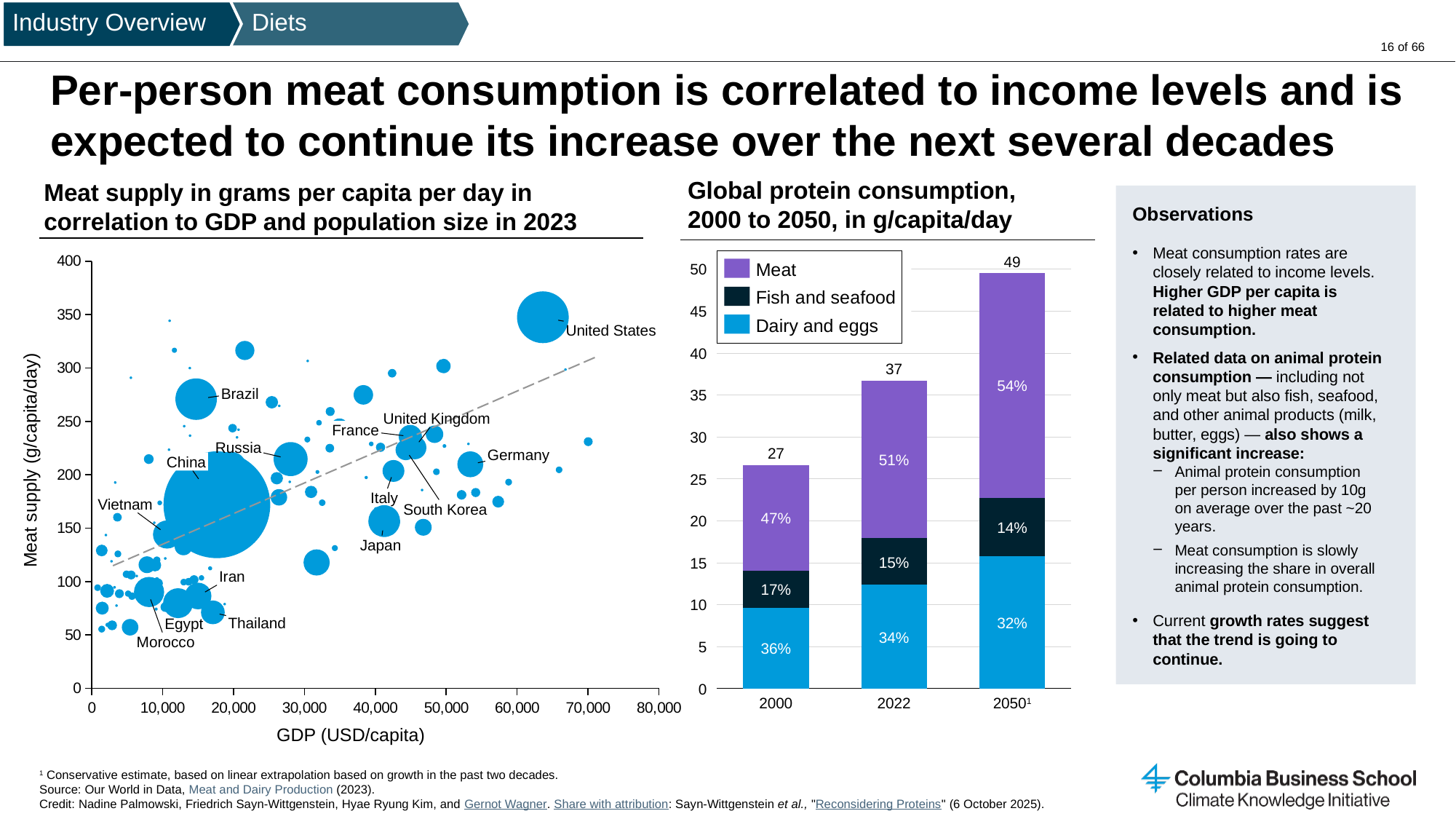
In the chart titled 'Global protein consumption, 2000 to 2050, in g/capita/day', what kind of chart is it? stacked bar chart In the chart titled 'Global protein consumption, 2000 to 2050, in g/capita/day', which year has the highest total? 2050 In the chart titled 'Meat supply in grams per capita per day in correlation to GDP and population size in 2023', is the meat supply value for the United States greater or less than 300? greater In the chart titled 'Global protein consumption, 2000 to 2050, in g/capita/day', what share of the 2050 bar is Meat? 54% In the chart titled 'Meat supply in grams per capita per day in correlation to GDP and population size in 2023', which labeled country has the highest meat supply? United States In the chart titled 'Global protein consumption, 2000 to 2050, in g/capita/day', what is the difference between the 2050 total and the 2000 total? 22 In the chart titled 'Global protein consumption, 2000 to 2050, in g/capita/day', what share of the 2022 bar is Fish and seafood? 15% In the chart titled 'Global protein consumption, 2000 to 2050, in g/capita/day', what share of the 2000 bar is Dairy and eggs? 36% In the chart titled 'Global protein consumption, 2000 to 2050, in g/capita/day', do the totals rise or fall from 2000 to 2050? rise In the chart titled 'Meat supply in grams per capita per day in correlation to GDP and population size in 2023', is the meat supply value for Japan greater or less than 200? less In the chart titled 'Global protein consumption, 2000 to 2050, in g/capita/day', how many series does the legend list? 3 In the chart titled 'Global protein consumption, 2000 to 2050, in g/capita/day', what is the total value of the bar for 2022? 37